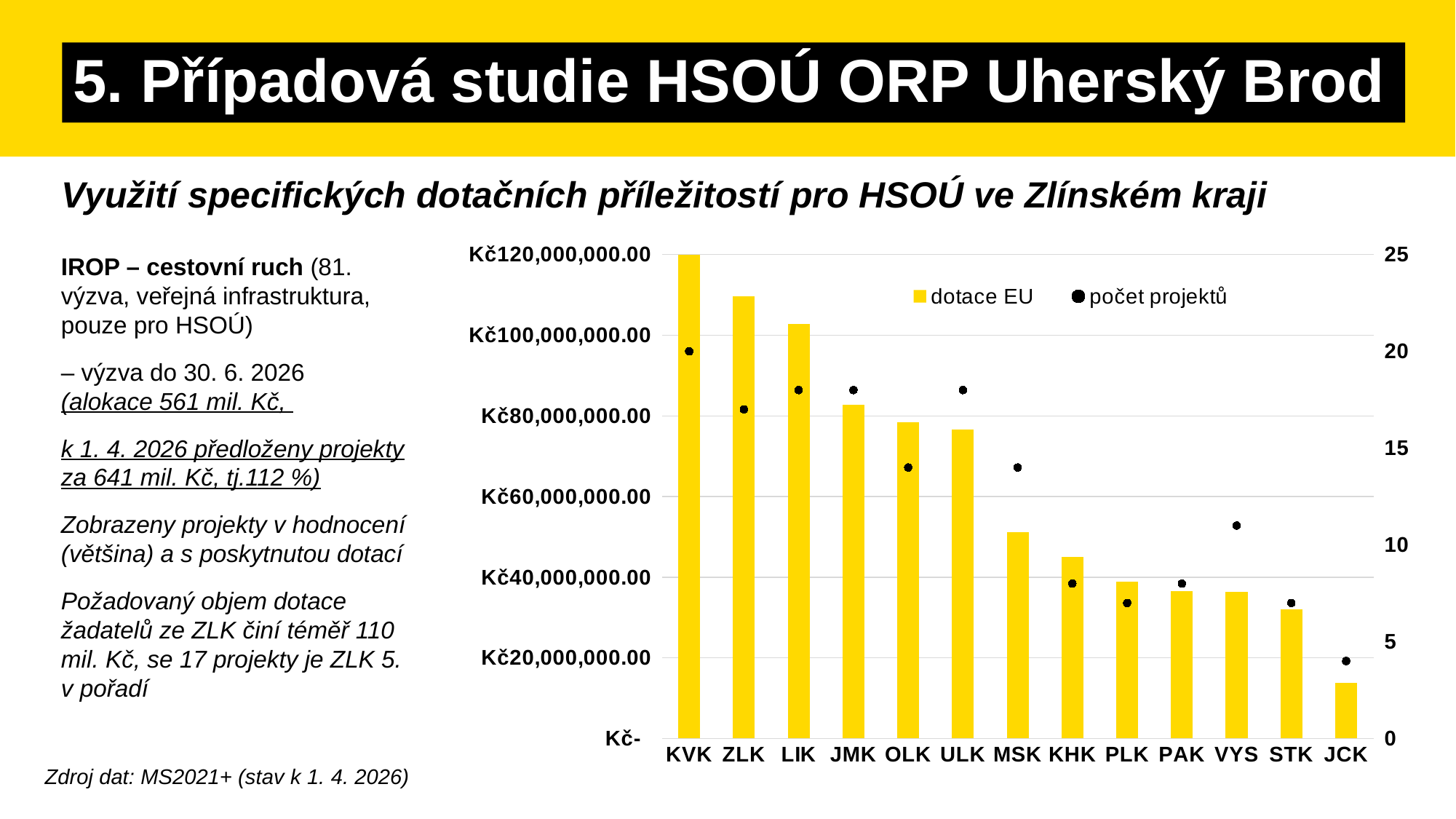
Is the dotace EU value for JCK greater or less than Kč20,000,000.00? less Do the dotace EU bars generally rise or fall from left to right along the x axis? fall Is the dotace EU value for ZLK greater or less than Kč100,000,000.00? greater How many series does the chart legend list? 2 Which region has the lowest dotace EU bar? JCK Which region has the highest počet projektů value? KVK Which region has the highest dotace EU bar? KVK Is the počet projektů value for VYS greater or less than 10? greater What are the two series named in the chart legend? dotace EU and počet projektů How many categories (regions) are shown on the x axis of the chart? 13 What is the počet projektů value for KVK? 20